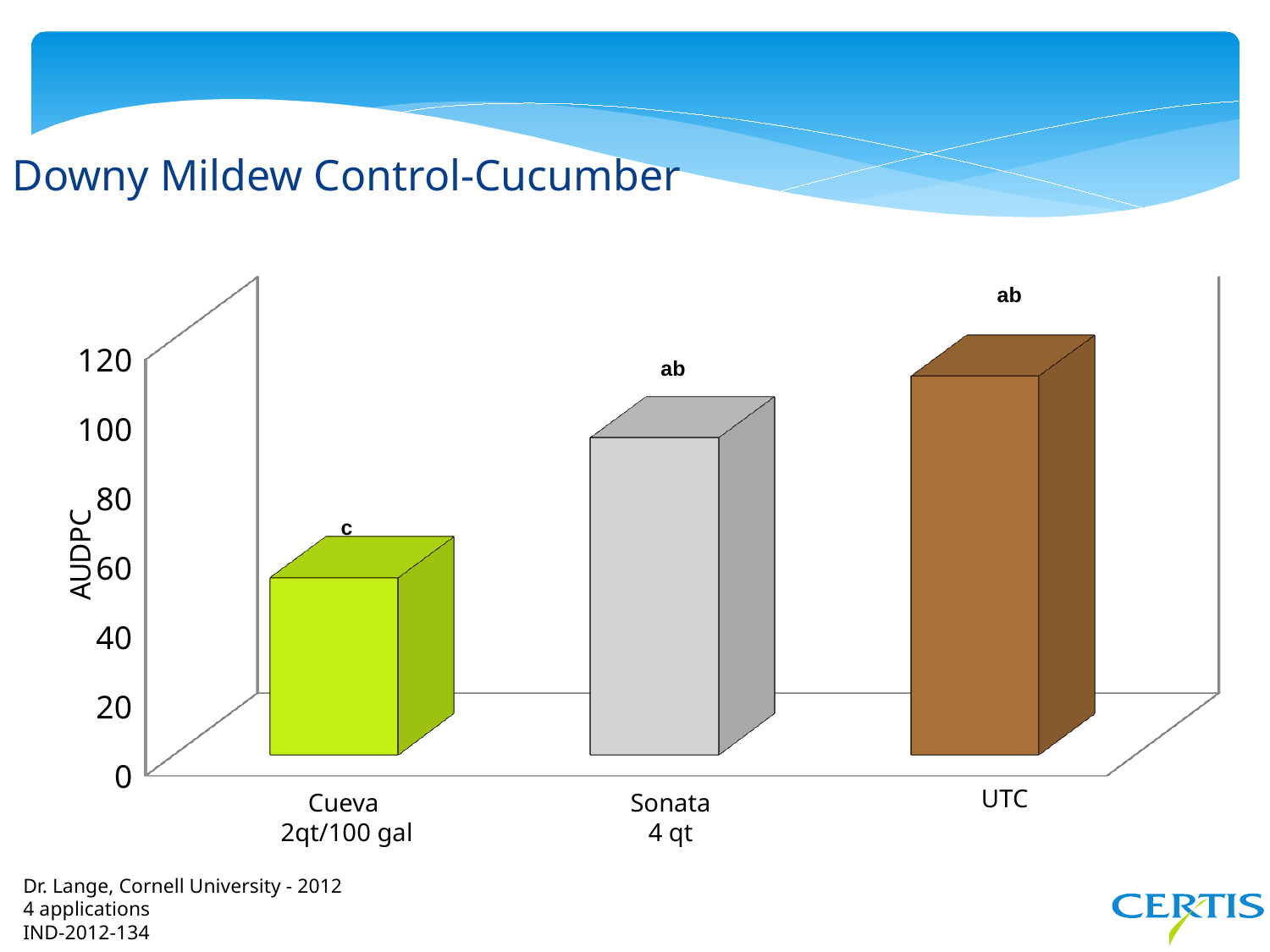
What is the label on the vertical axis of the chart? AUDPC Which has a larger AUDPC value, Cueva 2qt/100 gal or Sonata 4 qt? Sonata 4 qt Is the AUDPC value for UTC greater or less than 80? greater Do the AUDPC values rise or fall moving from Cueva to UTC along the x axis? rise Is the AUDPC value for Sonata 4 qt greater or less than 60? greater Which treatment has the lowest AUDPC value? Cueva 2qt/100 gal Which treatment has the highest AUDPC value? UTC How many treatment categories are plotted in the chart? 3 What kind of chart is shown on the slide? bar chart What letter is printed above the Cueva 2qt/100 gal bar? c Which has a larger AUDPC value, Sonata 4 qt or UTC? UTC Is the AUDPC value for Cueva 2qt/100 gal greater or less than 80? less